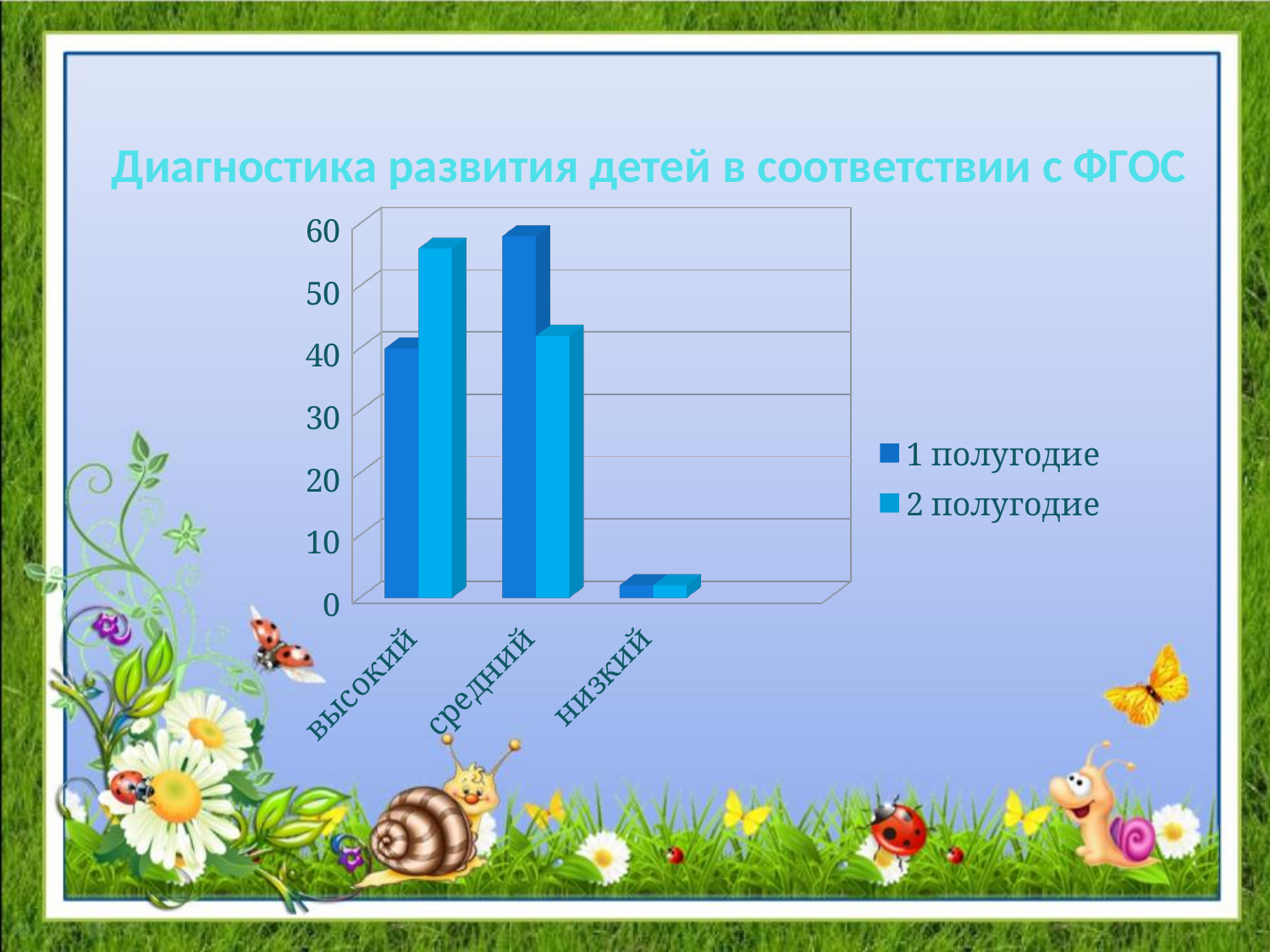
What is the title of the chart? Диагностика развития детей в соответствии с ФГОС For the category высокий, which series has the larger value, 1 полугодие or 2 полугодие? 2 полугодие Which category has the highest value for 1 полугодие? средний What kind of chart is shown on the slide? bar chart How many series does the legend list? 2 Is the value for низкий in 1 полугодие greater or less than 10? less Which category has the lowest value for 1 полугодие? низкий Which category has the highest value for 2 полугодие? высокий How many categories are shown on the x axis? 3 Is the value for средний in 2 полугодие greater or less than 50? less Is the value for высокий in 2 полугодие greater or less than 50? greater For the category средний, which series has the larger value, 1 полугодие or 2 полугодие? 1 полугодие